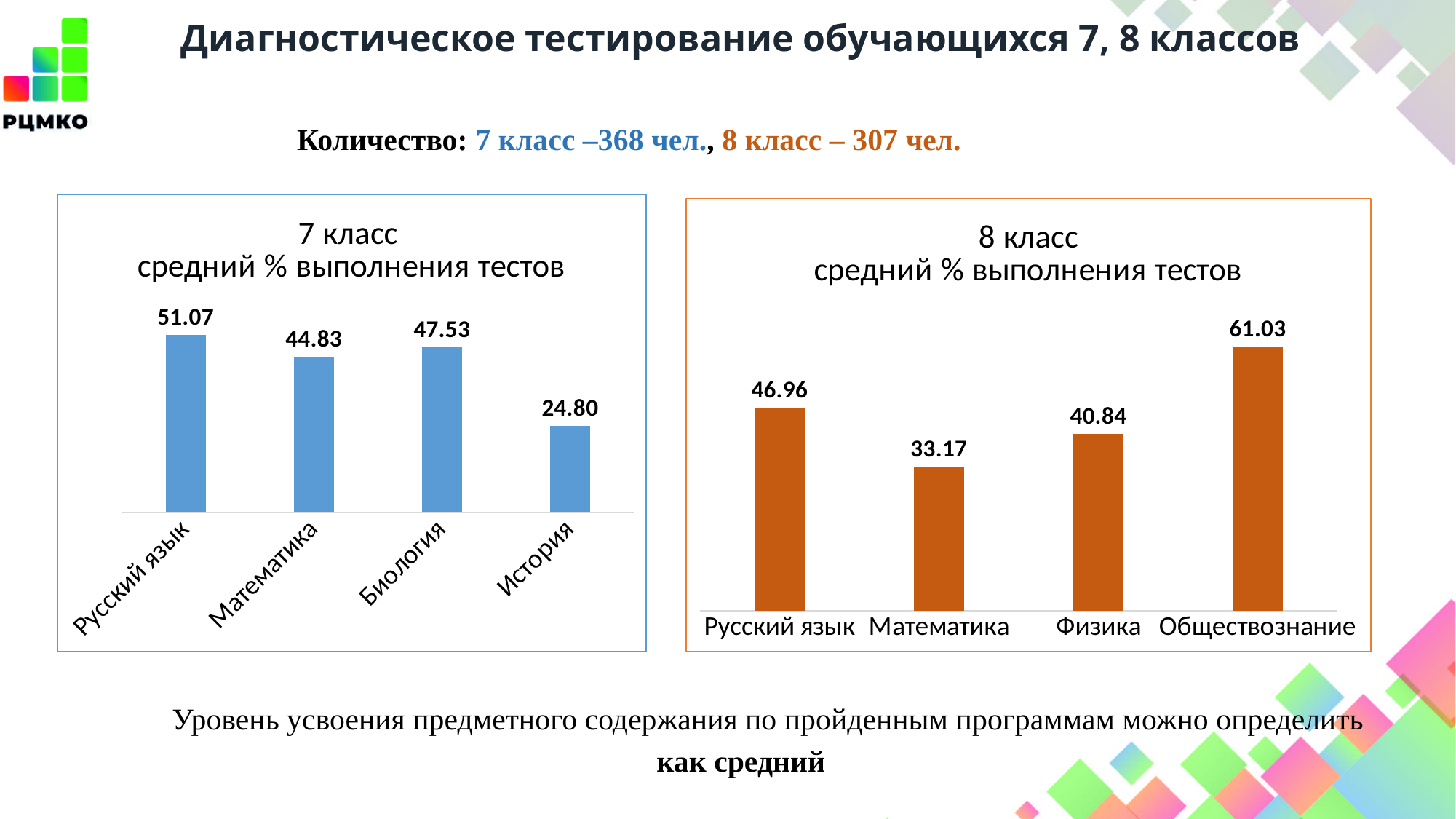
In the left chart (7 класс), what is the value for История? 24.80 In the left chart (7 класс), what is the value for Русский язык? 51.07 In the left chart (7 класс), what is the difference between Русский язык and История? 26.27 In the right chart (8 класс), what is the value for Физика? 40.84 In the right chart (8 класс), what is the value for Математика? 33.17 In the left chart (7 класс), which is larger: Математика or Биология? Биология In the right chart (8 класс), which subject has the highest value? Обществознание What type of chart is the left chart (7 класс)? Bar chart In the right chart (8 класс), what is the difference between Обществознание and Математика? 27.86 In the right chart (8 класс), which subject has the lowest value? Математика How many subjects are shown in the right chart (8 класс)? 4 In the left chart (7 класс), which subject has the highest value? Русский язык